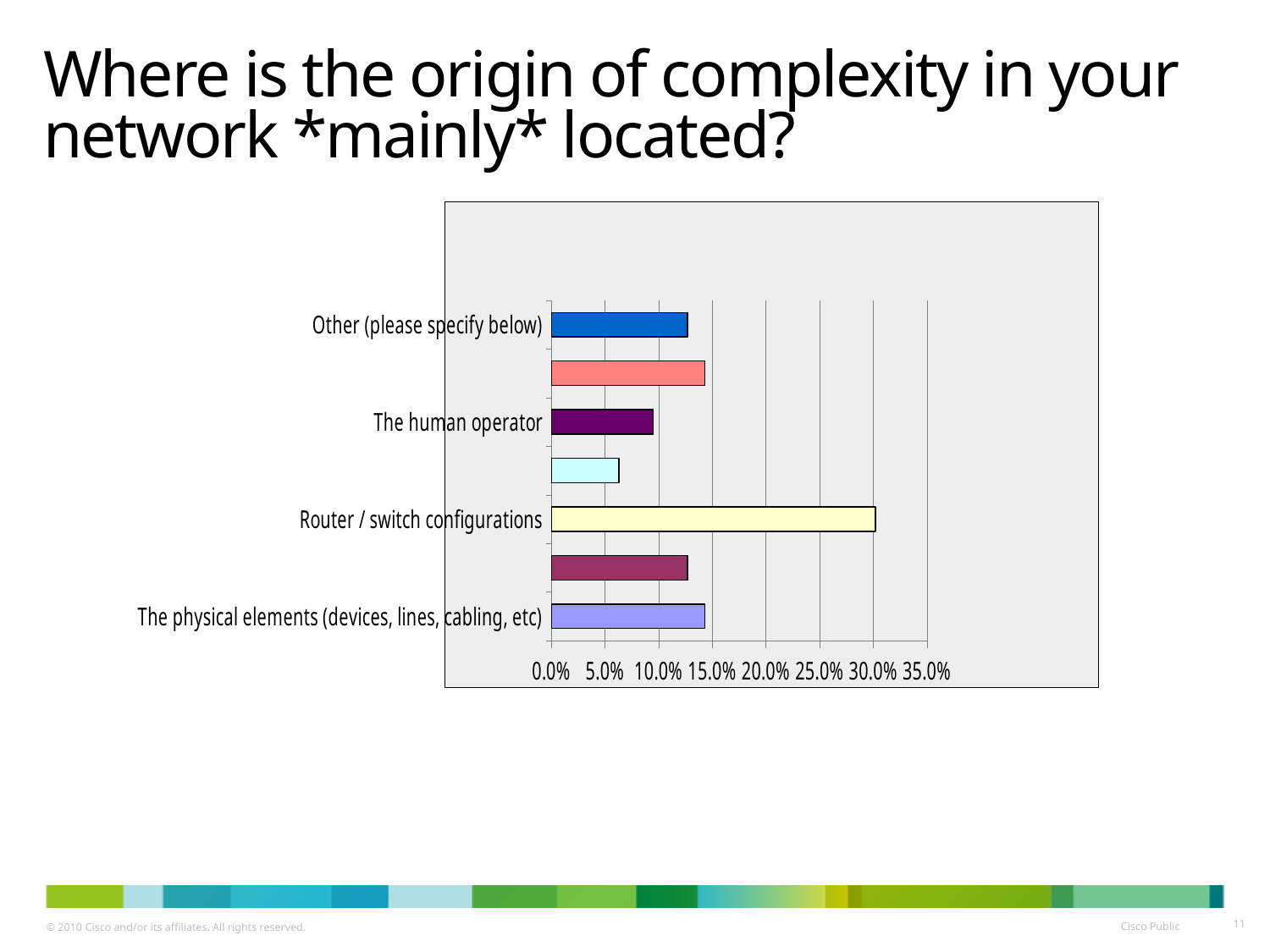
Is the value for The physical elements (devices, lines, cabling, etc) greater or less than 10.0%? greater How many bars are plotted in the chart? 7 Which category has the highest value in the chart? Router / switch configurations Which is larger: the value for Other (please specify below) or the value for Router / switch configurations? Router / switch configurations Which is larger: the value for The physical elements (devices, lines, cabling, etc) or the value for The human operator? The physical elements (devices, lines, cabling, etc) Which is larger: the value for Router / switch configurations or the value for The human operator? Router / switch configurations What kind of chart is shown on the slide? bar chart What is the highest value shown on the chart's horizontal axis? 35.0% Is the value for Router / switch configurations greater or less than 25.0%? greater Is the value for Other (please specify below) greater or less than 10.0%? greater